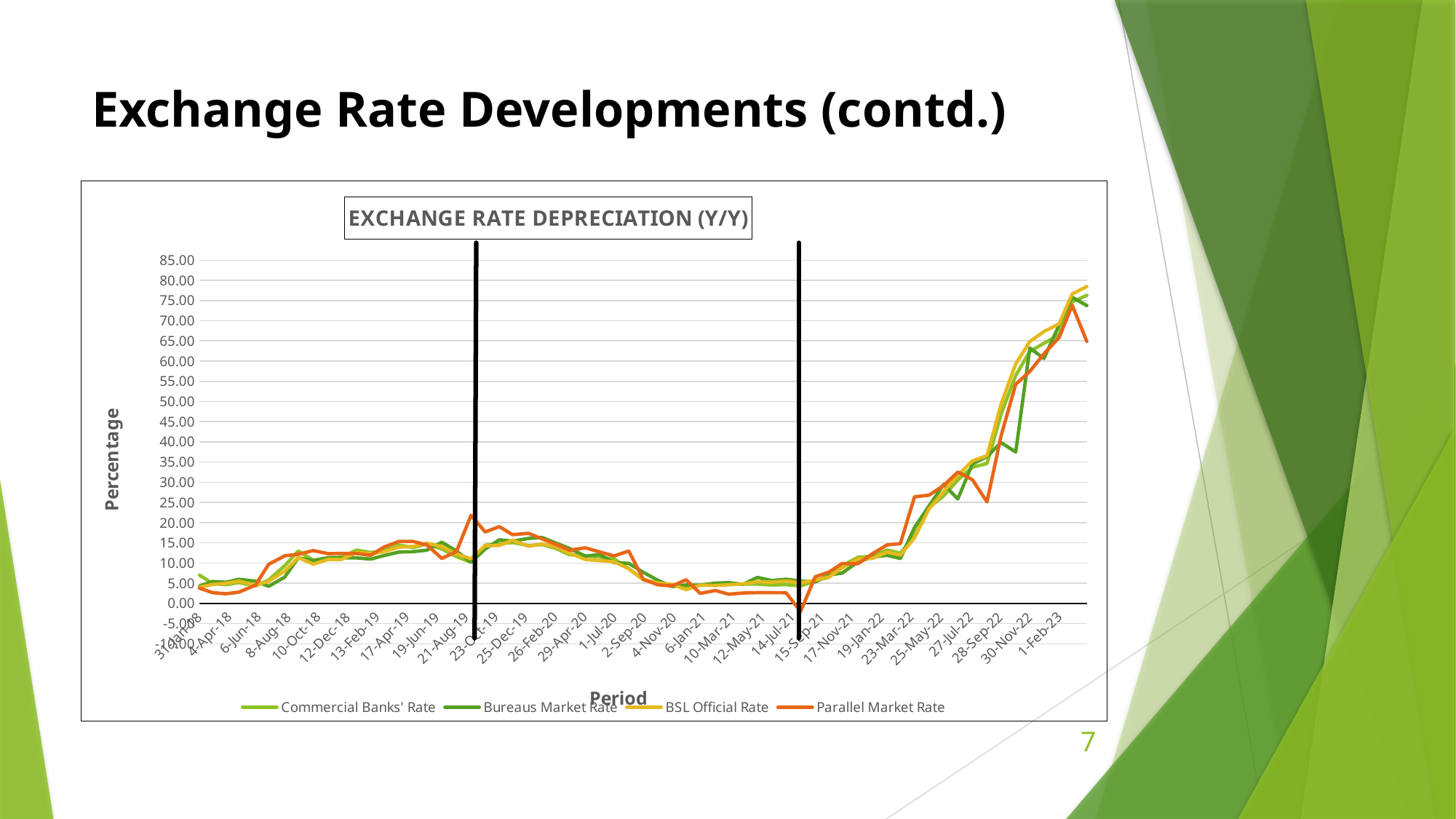
Is the value for the Parallel Market Rate at 1-Feb-23 greater or less than 60.00? greater Is the value for the BSL Official Rate at 6-Jan-21 greater or less than 10.00? less What kind of chart is shown on the slide? line chart What is the label on the vertical axis of the chart? Percentage Is the value for the Parallel Market Rate at 14-Jul-21 greater or less than 5.00? less What is the title of the chart? EXCHANGE RATE DEPRECIATION (Y/Y) Which series has the lowest value at the last point on the chart? Parallel Market Rate Do the series generally rise or fall between 15-Sep-21 and 1-Feb-23? rise At the last point on the chart, which is higher: the BSL Official Rate or the Parallel Market Rate? BSL Official Rate Do the series generally rise or fall between 23-Oct-19 and 4-Nov-20? fall How many series does the legend list? 4